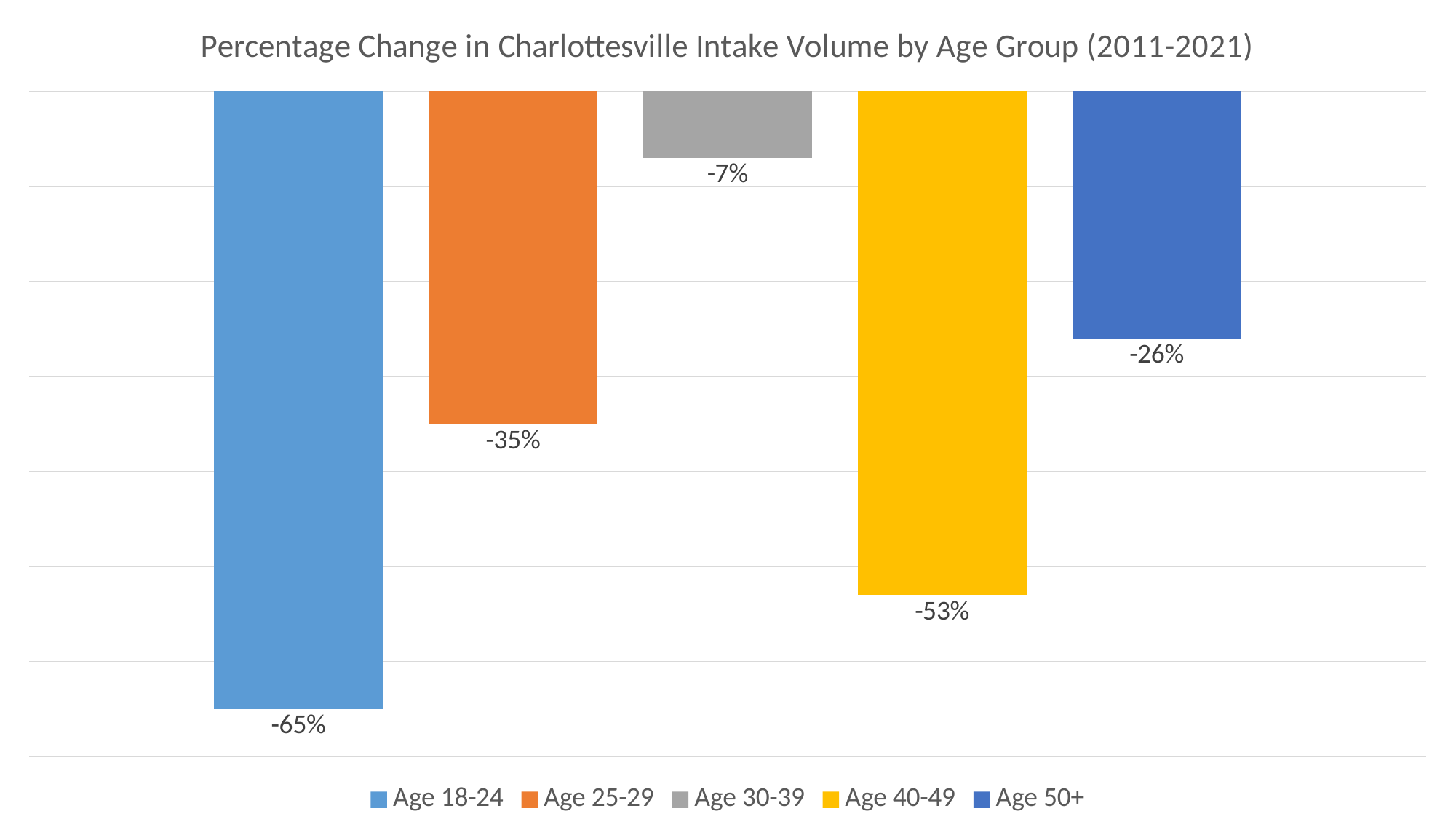
What is the title of the chart? Percentage Change in Charlottesville Intake Volume by Age Group (2011-2021) What is the percentage change in intake volume for Age 30-39? -7% What type of chart is shown on the slide? Bar chart Which age group has the smallest percentage decrease in intake volume? Age 30-39 Which age group shows a larger decrease in intake volume, Age 40-49 or Age 50+? Age 40-49 How many entries does the legend list? 5 What is the percentage change in intake volume for Age 18-24? -65% How many age groups are shown in the chart? 5 Which age group has the largest percentage decrease in intake volume? Age 18-24 What is the difference in percentage points between the change for Age 18-24 and Age 25-29? 30 percentage points What is the percentage change in intake volume for Age 50+? -26% What is the percentage change in intake volume for Age 40-49? -53%